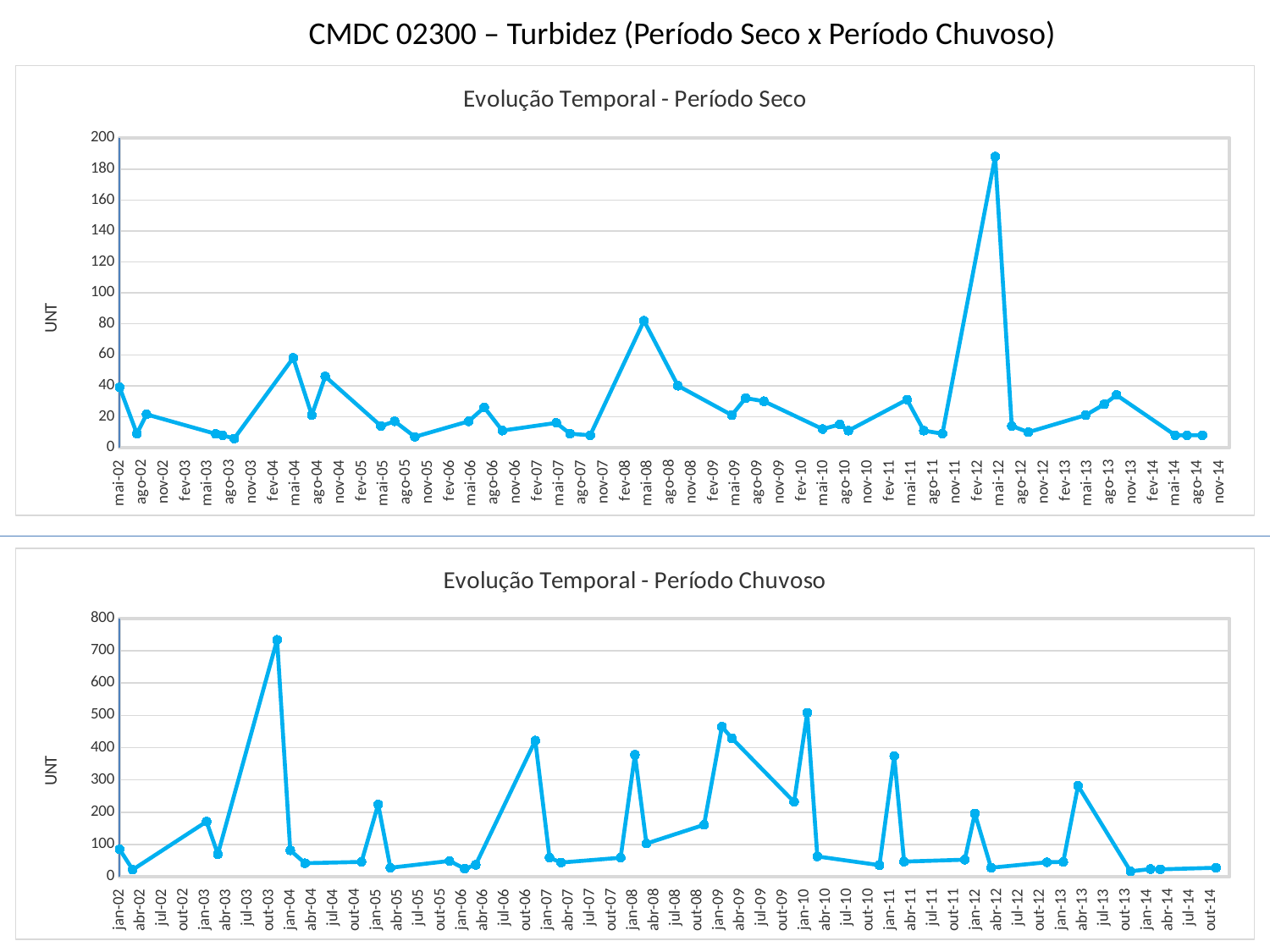
In the top chart 'Evolução Temporal - Período Seco', is the value for mai-12 greater or less than 160? greater In the bottom chart 'Evolução Temporal - Período Chuvoso', is the value for out-03 greater or less than 600? greater What is the y-axis label on the bottom chart 'Evolução Temporal - Período Chuvoso'? UNT In the bottom chart 'Evolução Temporal - Período Chuvoso', is the value for jan-10 greater or less than 400? greater What kind of chart is the top chart, 'Evolução Temporal - Período Seco'? Line chart In the top chart 'Evolução Temporal - Período Seco', which date has the highest value? mai-12 In the top chart 'Evolução Temporal - Período Seco', which is larger, the value for mai-08 or the value for mai-04? mai-08 In the bottom chart 'Evolução Temporal - Período Chuvoso', which is larger, the value for out-03 or the value for jan-10? out-03